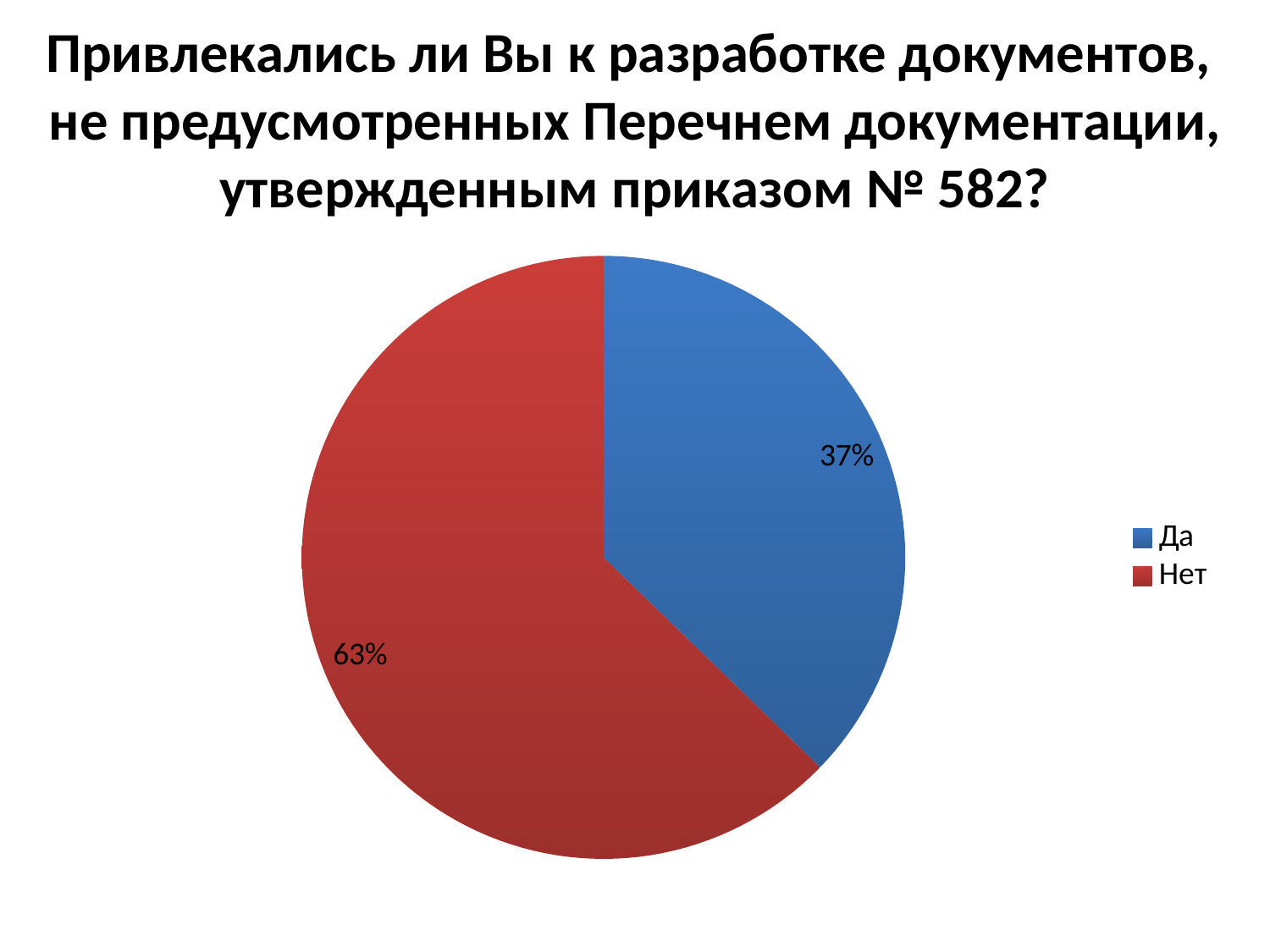
What percentage of respondents answered "Да"? 37% What kind of chart is shown on the slide? Pie chart What colour is the "Нет" slice? Red What colour is the "Да" slice? Blue What is the difference in percentage points between the "Нет" and "Да" slices? 26 How many entries does the legend list? 2 What percentage of respondents answered "Нет"? 63% Which answer has the largest share of the pie? Нет Which is larger, the share for "Да" or the share for "Нет"? Нет What share of the pie does the "Да" slice represent? 37% Which answer has the smallest share of the pie? Да How many slices does the pie chart have? 2